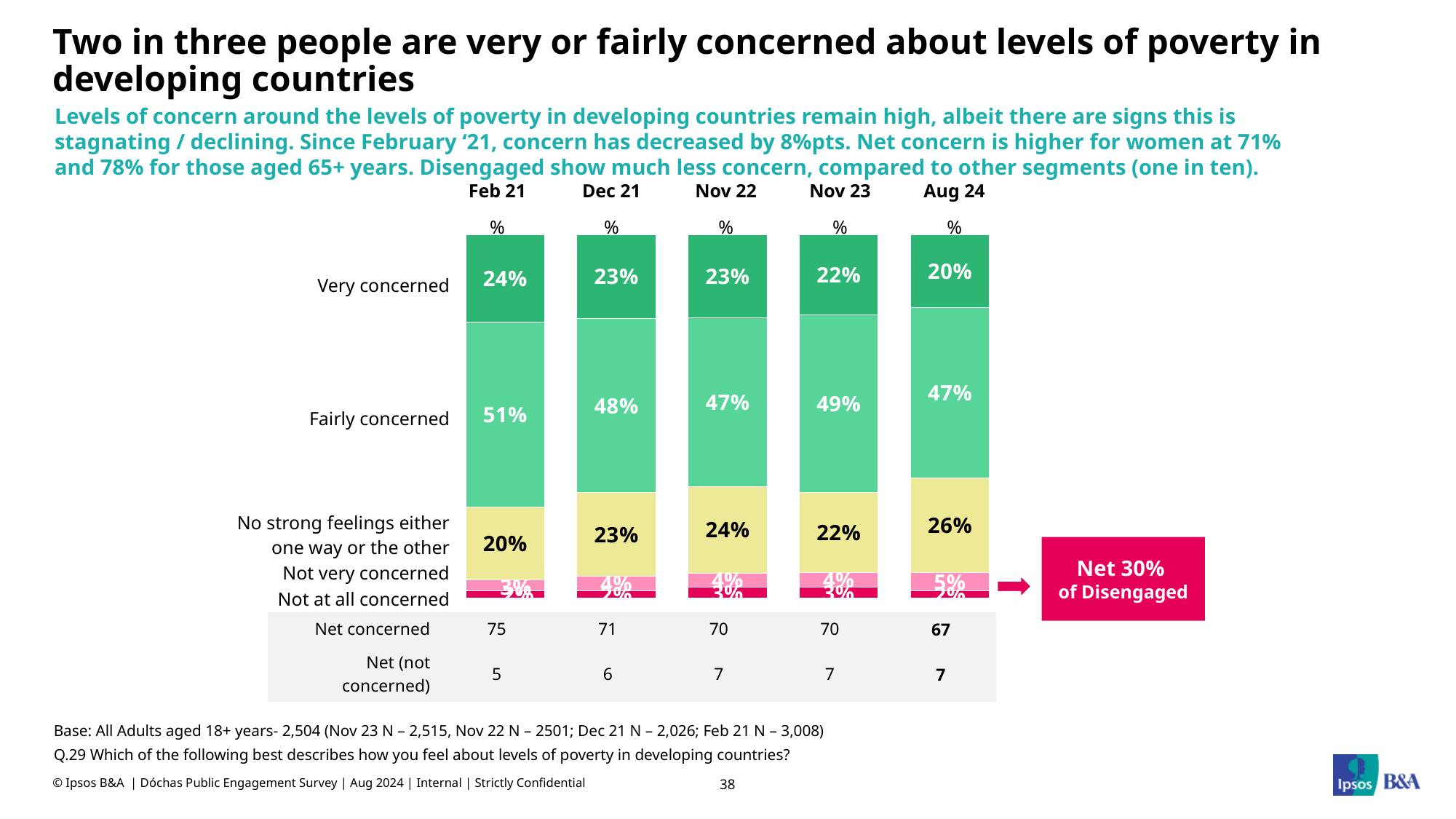
What percentage of people were 'Very concerned' in Aug 24? 20% In which period was the 'No strong feelings either one way or the other' share lowest? Feb 21 In which period was the 'Very concerned' share highest? Feb 21 What is the 'Net concerned' figure for Aug 24? 67 How many time periods are shown in the chart? 5 By how many percentage points did 'Fairly concerned' fall from Feb 21 to Aug 24? 4 What percentage of people were 'Fairly concerned' in Feb 21? 51% What percentage had 'No strong feelings either one way or the other' in Nov 22? 24% What type of chart is shown on the slide? Stacked bar chart Which is larger: 'Fairly concerned' in Nov 23 or 'Fairly concerned' in Nov 22? Nov 23 Does the 'Net concerned' figure rise or fall from Feb 21 to Aug 24? Fall What is the combined 'Very concerned' and 'Fairly concerned' share in Dec 21? 71%